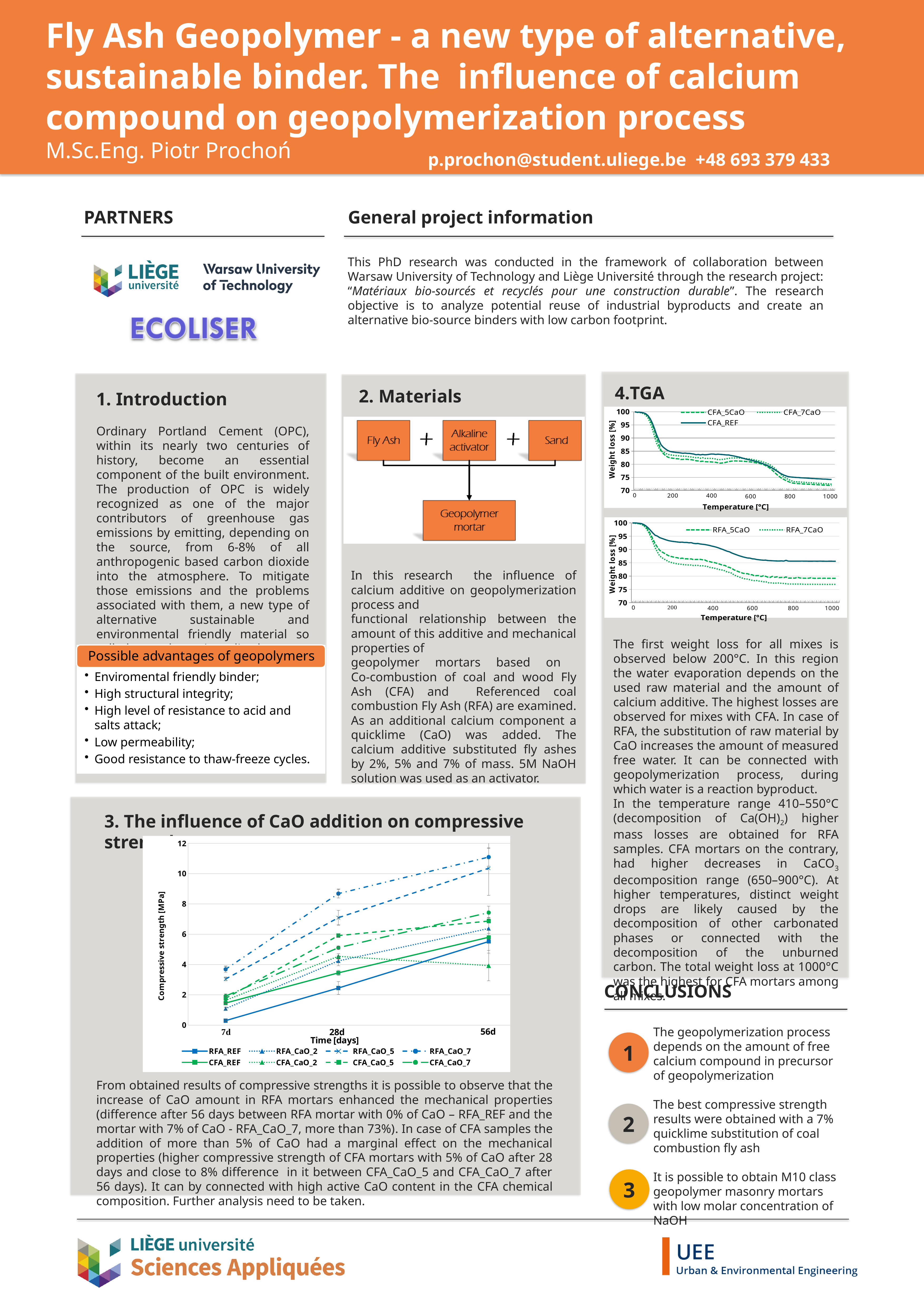
In the top TGA chart (section 4), how many series does the legend list? 3 In the top TGA chart (section 4), does the weight loss value for CFA_REF rise or fall as temperature increases from 0 to 1000 °C? fall In the compressive strength chart (section 3), is the value for RFA_REF at 7d greater or less than 2? less In the compressive strength chart (section 3), how many time points are shown on the x axis? 3 In the compressive strength chart (section 3), is the value for RFA_CaO_7 at 56d greater or less than 10? greater In the top TGA chart (section 4), is the value for CFA_REF at 1000 °C greater or less than 80? less In the bottom TGA chart (section 4), how many series does the legend list? 2 In the compressive strength chart (section 3), does the compressive strength of RFA_REF rise or fall from 7d to 56d? rise In the compressive strength chart (section 3), how many series does the legend list? 8 In the compressive strength chart (section 3), which series has the lowest value at 56d? CFA_CaO_2 What kind of chart is used in section 3, 'The influence of CaO addition on compressive strength'? line chart In the compressive strength chart (section 3), which has the larger value at 56d: RFA_CaO_7 or CFA_CaO_2? RFA_CaO_7